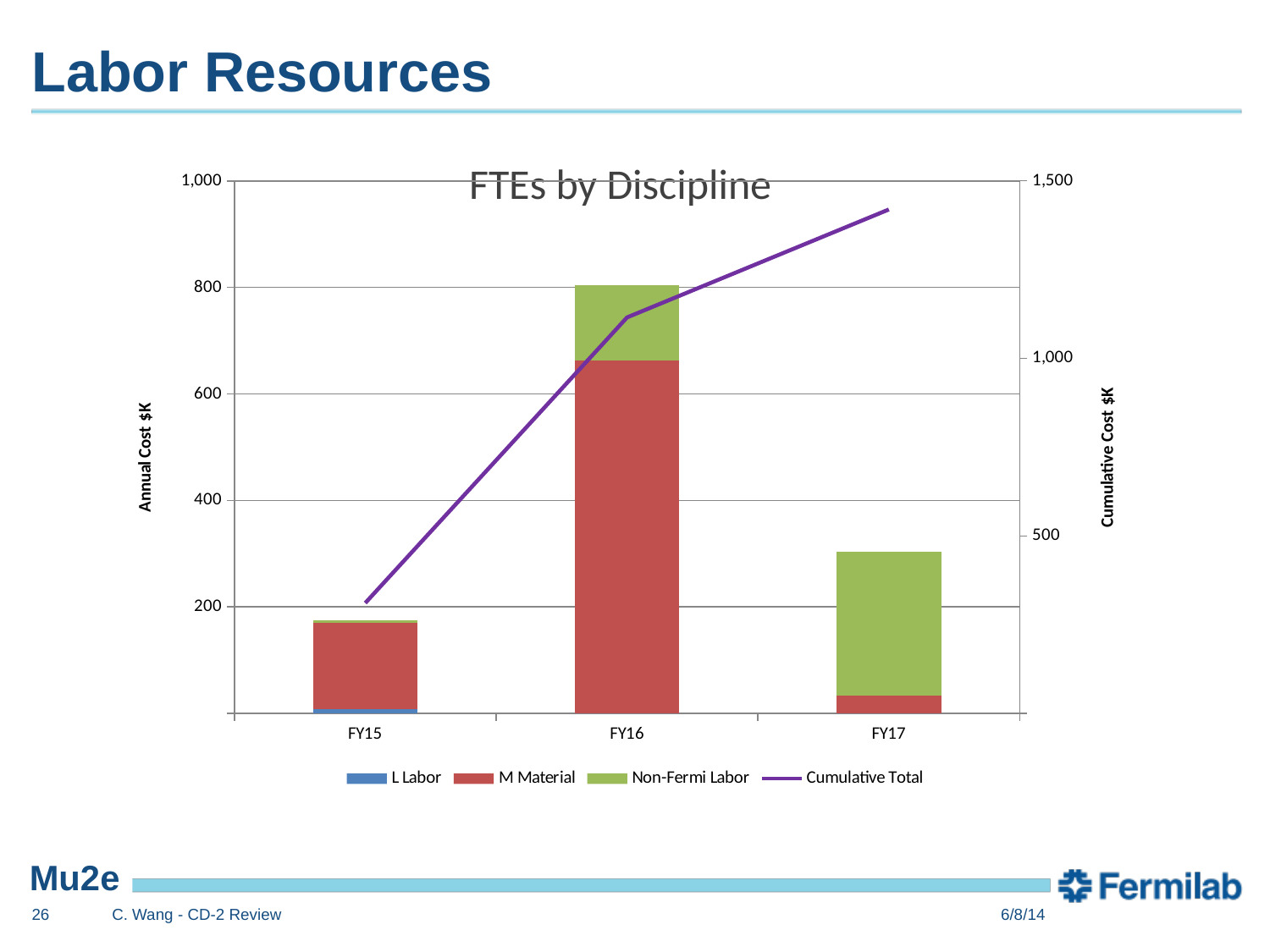
Is the Cumulative Total value for FY17 greater or less than 1,000 on the Cumulative Cost axis? greater Is the total stacked bar for FY16 greater or less than 600 on the Annual Cost axis? greater How many series does the chart legend list? 4 What kind of chart is shown on the slide? A combination of a stacked bar chart and a line chart Does the Cumulative Total line rise or fall from FY15 to FY17? It rises Which fiscal year has the larger Non-Fermi Labor segment, FY16 or FY17? FY17 Is the total stacked bar for FY15 greater or less than 200 on the Annual Cost axis? less Which fiscal year has the tallest stacked bar? FY16 How many fiscal years are shown on the x axis of the chart? 3 Which fiscal year has the shortest stacked bar? FY15 What is the title printed inside the chart area? FTEs by Discipline